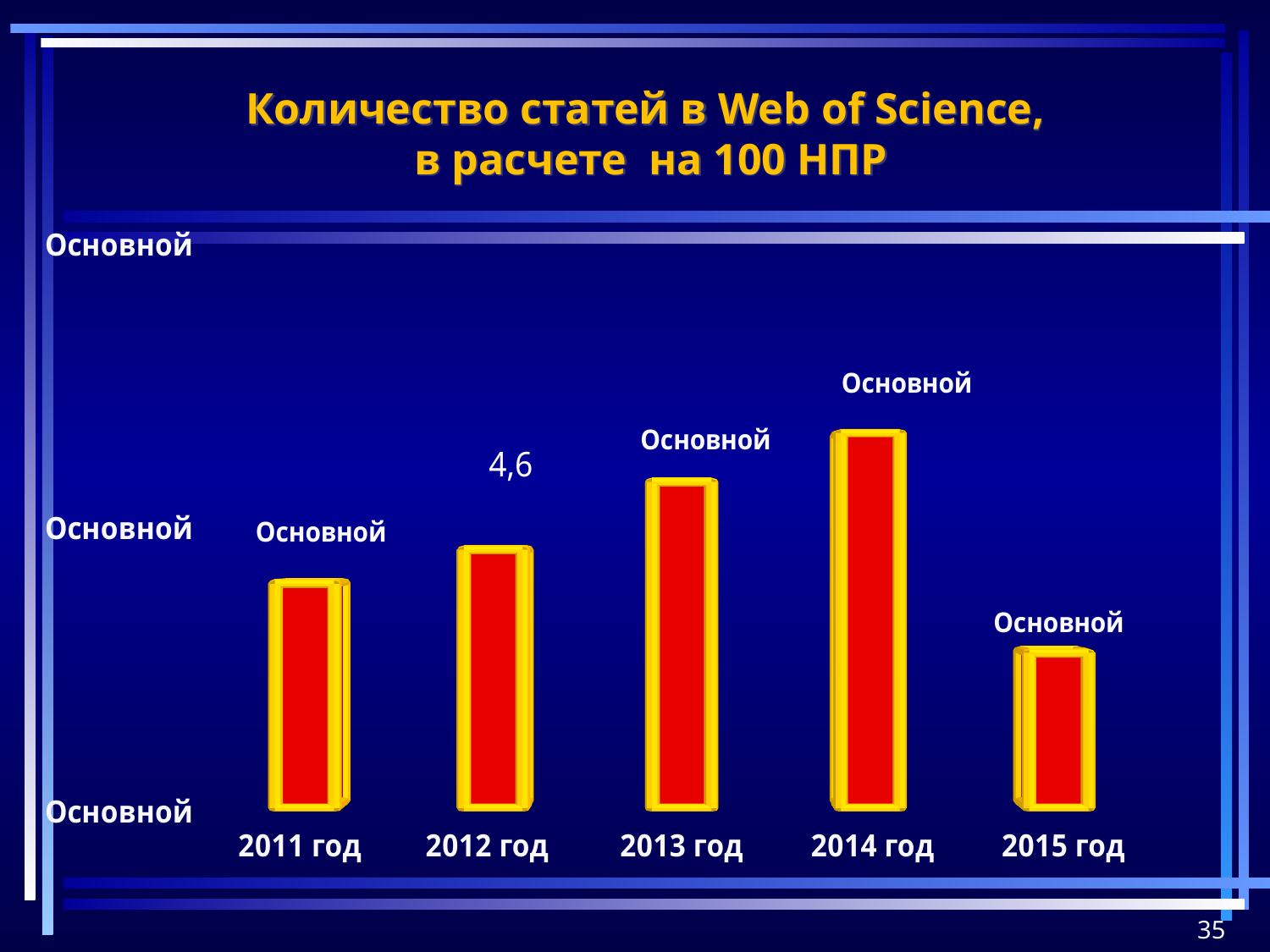
Which is larger, the value for 2011 год or 2015 год? 2011 год Which year has the highest bar? 2014 год Which is larger, the value for 2013 год or 2014 год? 2014 год What is the value for 2012 год? 4,6 How many years are shown on the x axis? 5 Which year has the lowest bar? 2015 год Do the values rise or fall from 2011 год to 2014 год? Rise Which is larger, the value for 2011 год or 2012 год? 2012 год Do the values rise or fall from 2014 год to 2015 год? Fall What colour are the bars in the chart? Red What kind of chart is shown on the slide? Bar chart What is the title of the chart? Количество статей в Web of Science, в расчете на 100 НПР